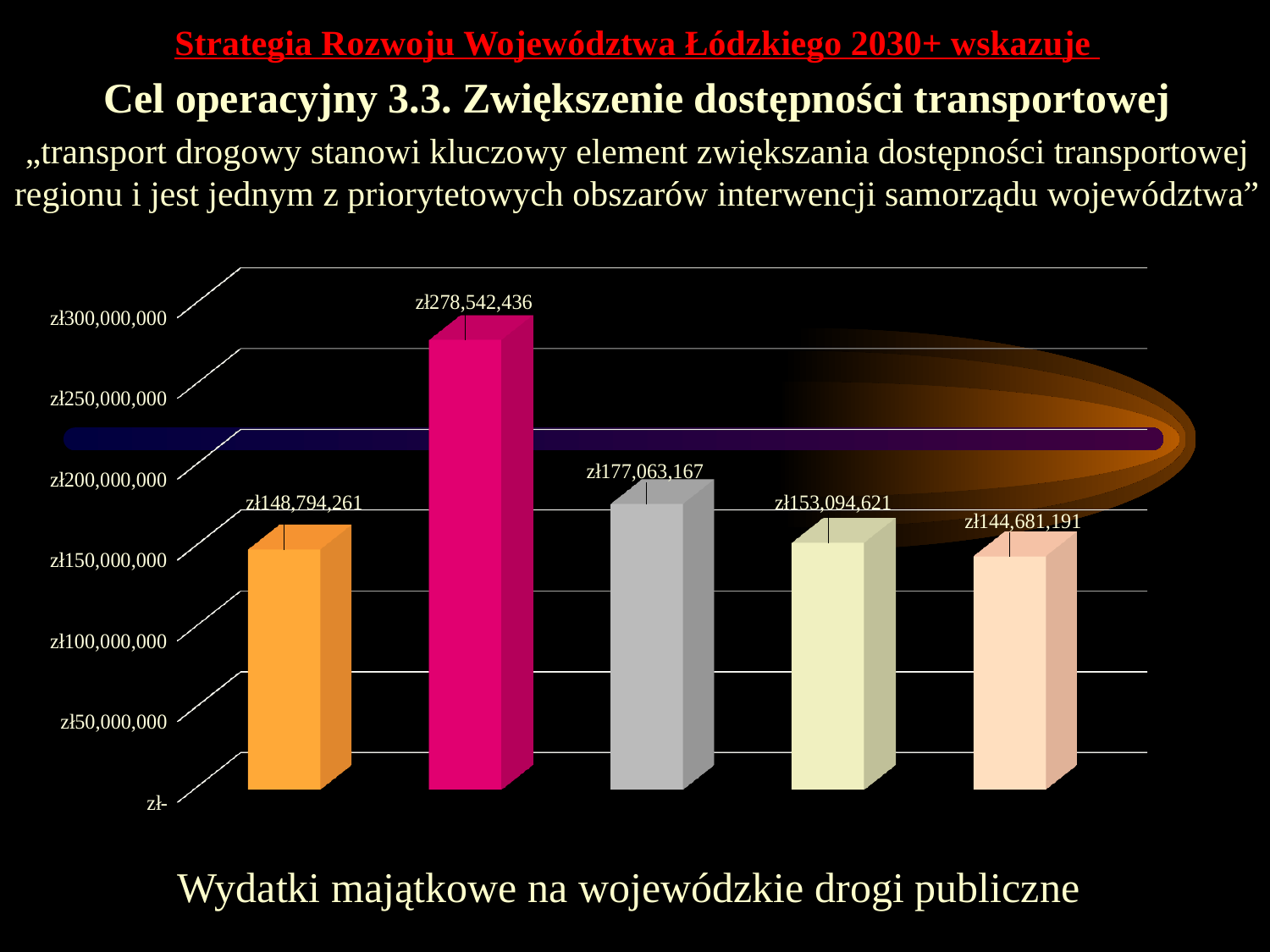
What is the value shown on the second (magenta) bar? zł278,542,436 What is the difference between the second bar (zł278,542,436) and the third bar (zł177,063,167)? zł101,479,269 What kind of chart is shown on the slide? Bar chart What is the value shown on the third (grey) bar? zł177,063,167 What is the value shown on the fifth (rightmost, peach) bar? zł144,681,191 What is the value shown on the first (leftmost, orange) bar? zł148,794,261 How many bars are plotted in the chart? 5 Which is larger, the value of the first bar or the value of the fourth bar? The fourth bar (zł153,094,621) What is the value shown on the fourth (light yellow) bar? zł153,094,621 Is the value of the third (grey) bar greater or less than zł200,000,000? less Which bar has the highest value? The second (magenta) bar, zł278,542,436 Which bar has the lowest value? The fifth (rightmost, peach) bar, zł144,681,191